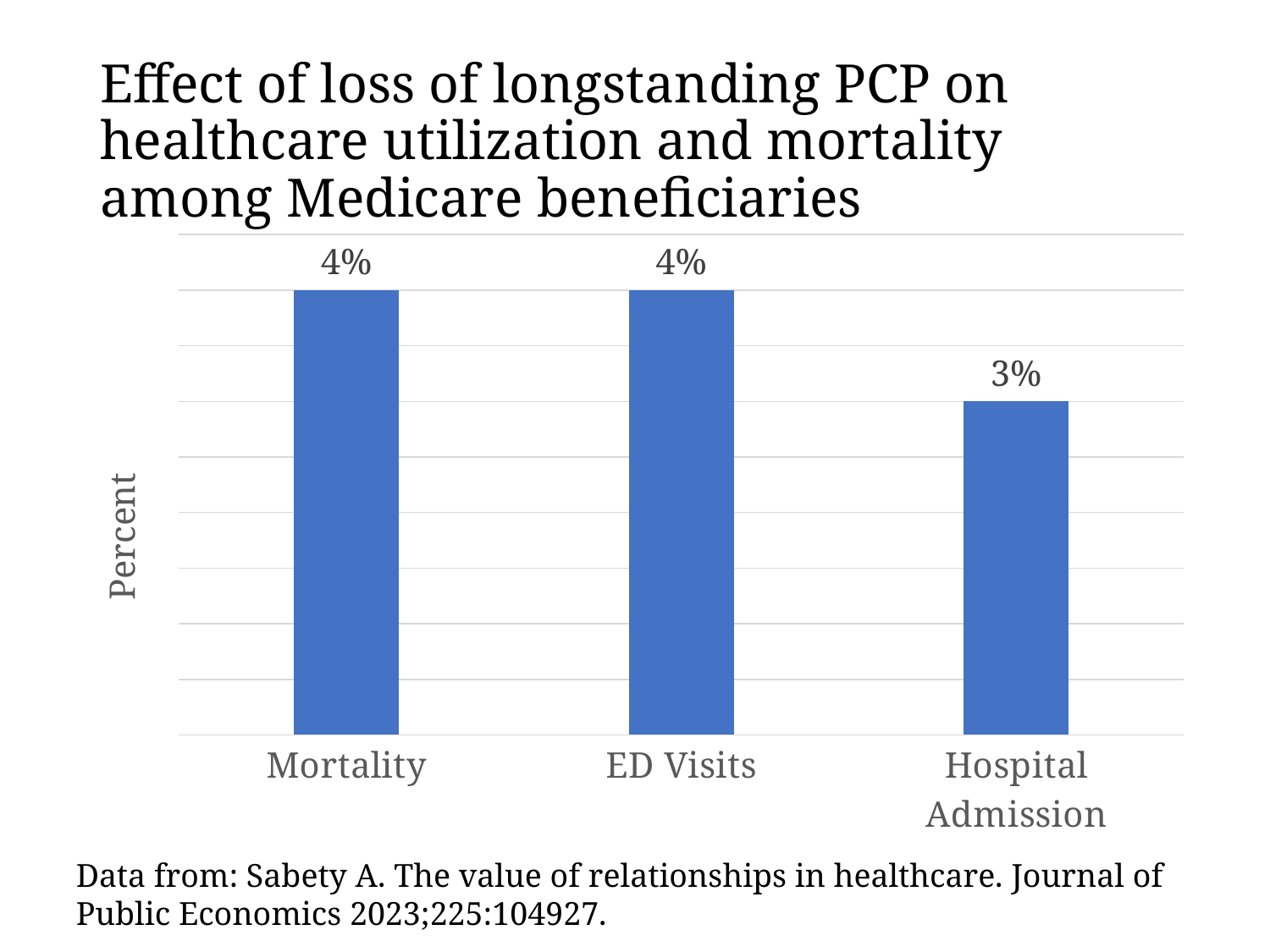
Which is larger, the value for Mortality or the value for Hospital Admission? Mortality What is the value for Mortality? 4% What is the difference between the values for Mortality and Hospital Admission? 1% Which category has the lowest value? Hospital Admission What is the value for ED Visits? 4% What is the label on the vertical axis? Percent How many categories are shown on the x axis? 3 What is the difference between the values for ED Visits and Hospital Admission? 1% What is the value for Hospital Admission? 3% What kind of chart is shown on the slide? Bar chart Which is larger, the value for ED Visits or the value for Hospital Admission? ED Visits What colour are the bars in the chart? Blue